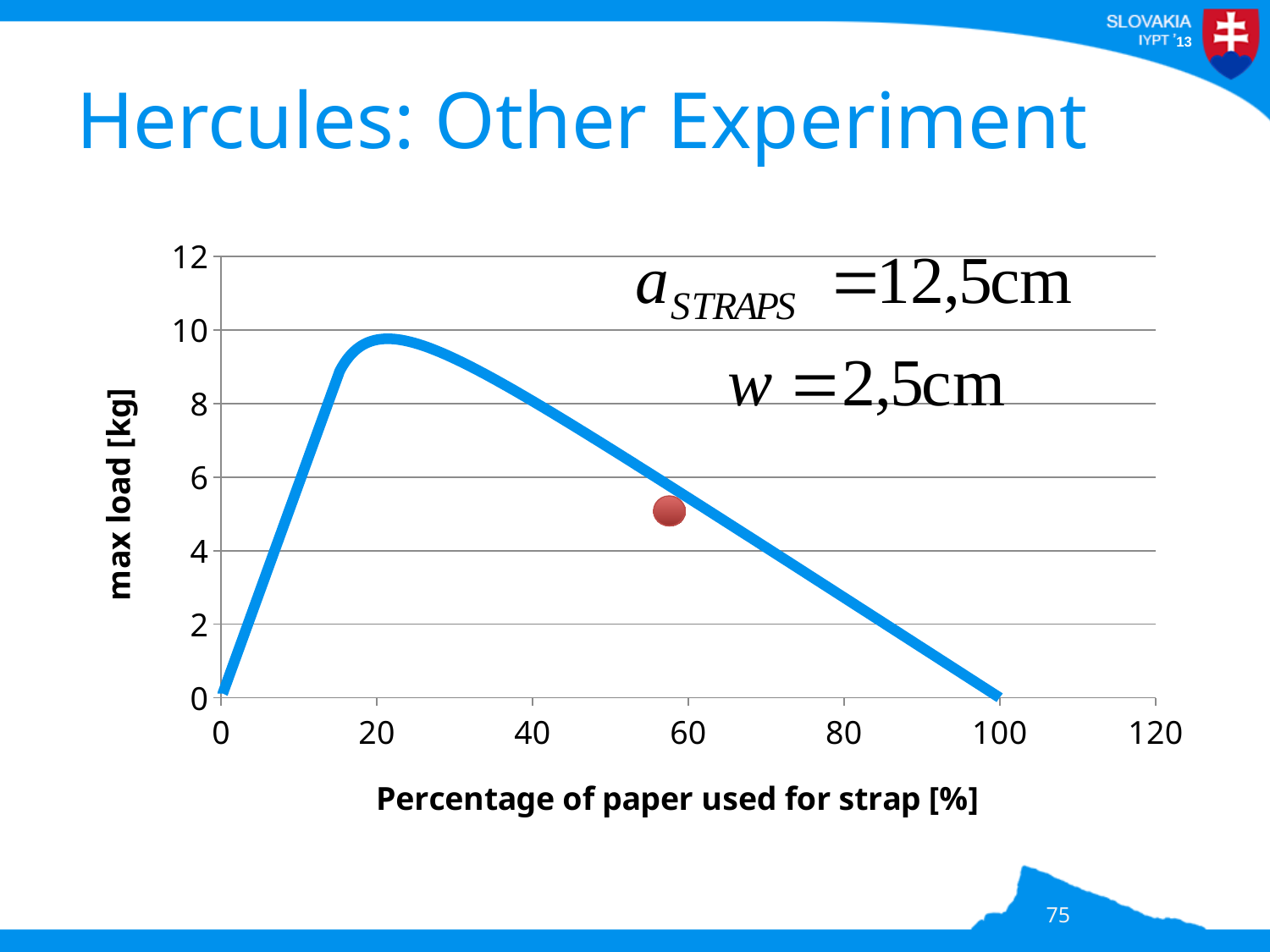
What is the title of the y axis? max load [kg] Is the peak value of the curve greater or less than 8? greater Does the curve rise or fall as the percentage increases from 20% to 100%? fall Is the value of the curve at 80% greater or less than 4? less What is the max load shown by the curve at 100% of paper used for strap? 0 What is the max load shown by the curve at 0% of paper used for strap? 0 What is the title of the x axis? Percentage of paper used for strap [%] What kind of chart is shown on the slide? line chart Is the peak value of the curve greater or less than 10? less Does the curve rise or fall as the percentage increases from 0% to 20%? rise